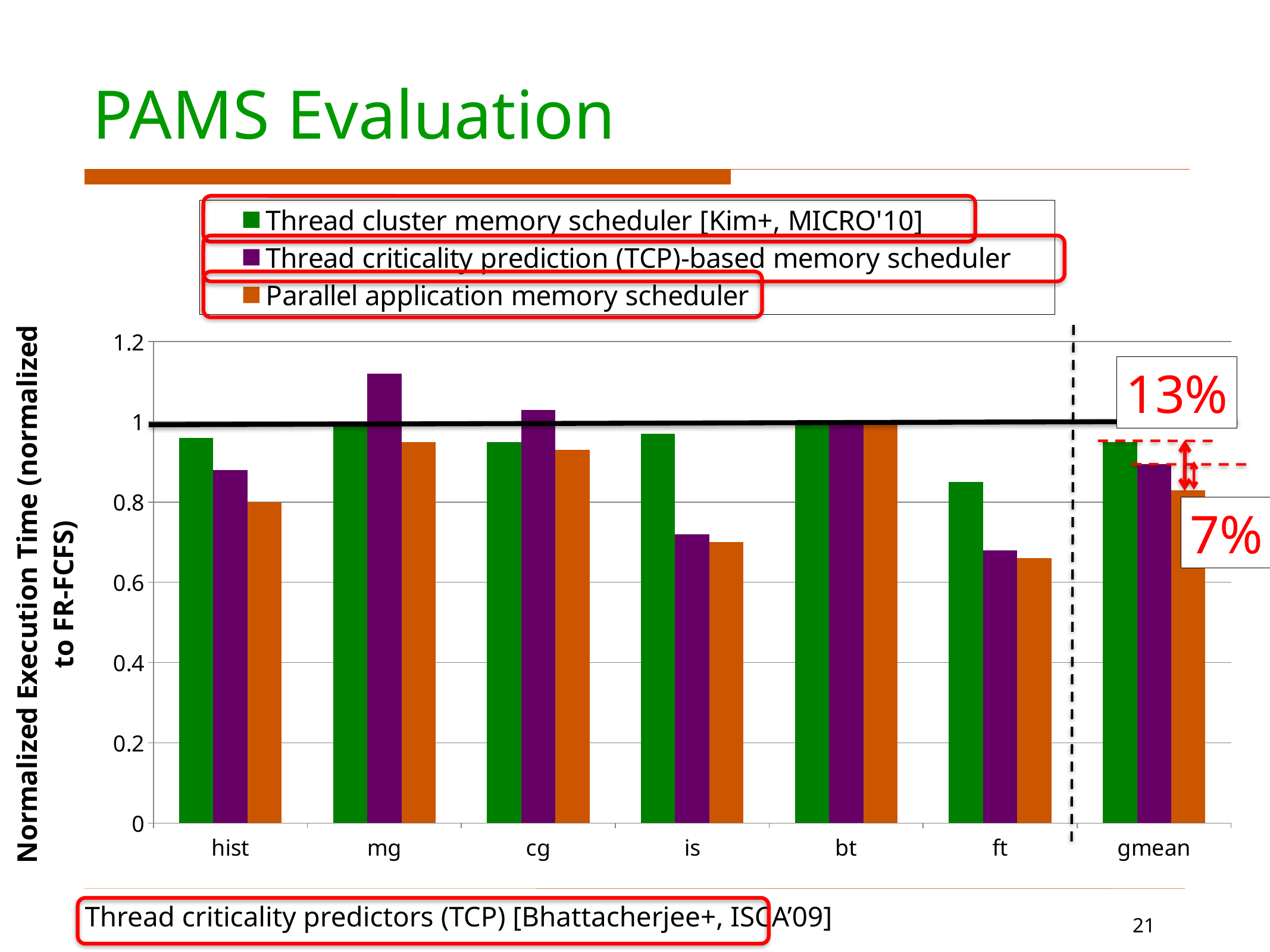
Which category has the highest value for the Thread criticality prediction (TCP)-based memory scheduler? mg Is the value for the Thread cluster memory scheduler on ft greater or less than 0.8? greater How many categories are shown on the x axis? 7 For mg, which is larger: the Thread criticality prediction (TCP)-based memory scheduler or the Parallel application memory scheduler? Thread criticality prediction (TCP)-based memory scheduler Which category has the lowest value for the Thread cluster memory scheduler? ft For ft, which is larger: the Thread cluster memory scheduler or the Thread criticality prediction (TCP)-based memory scheduler? Thread cluster memory scheduler Is the value for the Parallel application memory scheduler on is greater or less than 0.8? less What is the label of the y axis? Normalized Execution Time (normalized to FR-FCFS) How many series does the legend list? 3 What percentage is annotated in red next to the gmean bars above the 7% label? 13% Is the value for the Thread criticality prediction (TCP)-based memory scheduler on mg greater or less than 1? greater What kind of chart is shown on the slide? bar chart